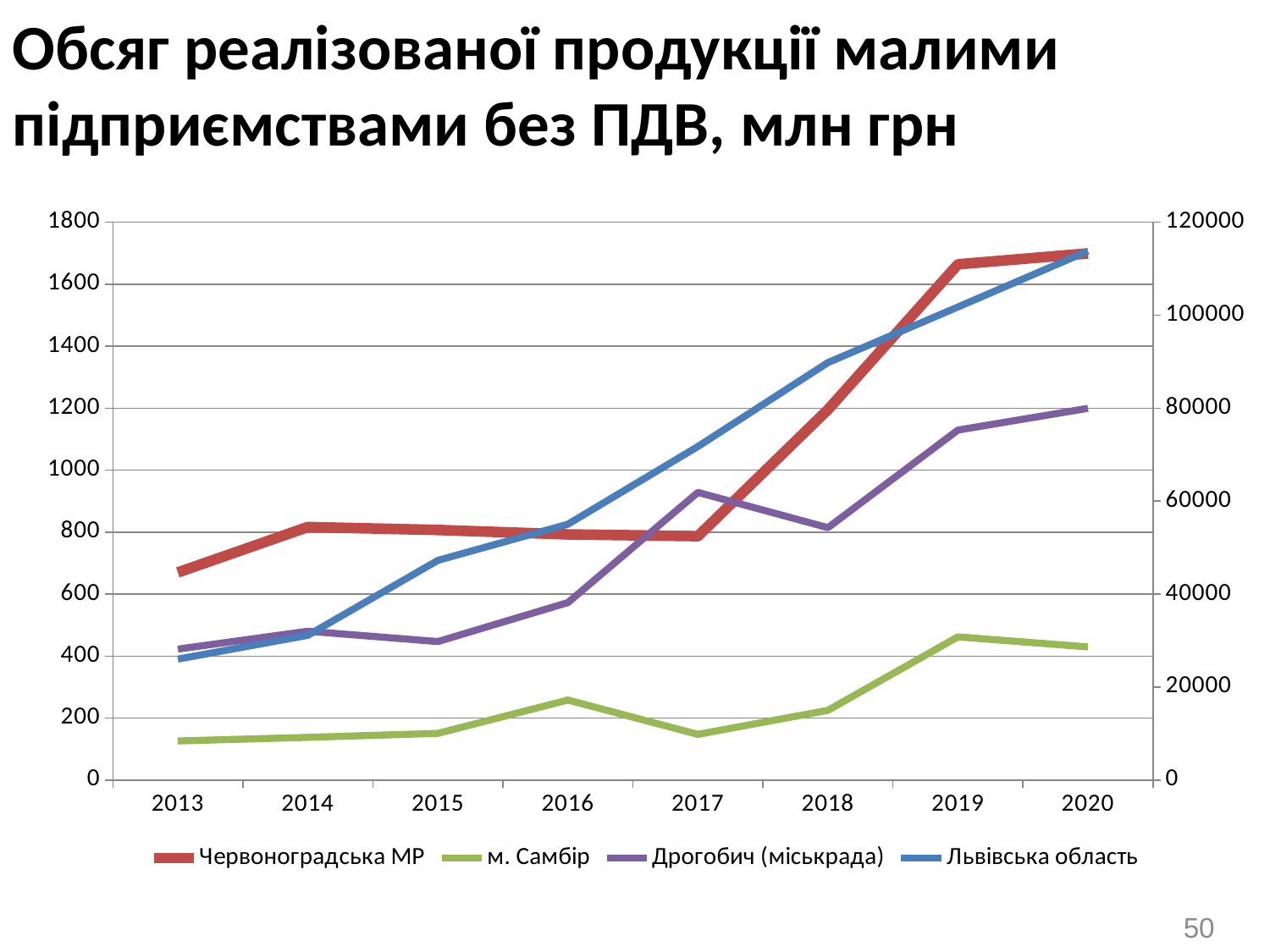
In 2017, which is larger: Дрогобич (міськрада) or Червоноградська МР? Дрогобич (міськрада) In which year is the value for м. Самбір highest? 2019 Which series is drawn in green? м. Самбір Is the value for Дрогобич (міськрада) in 2020 greater or less than 1000? greater Does the value for Львівська область rise or fall from 2013 to 2020? rise Is the value for Червоноградська МР in 2019 greater or less than 1400? greater In which year is the value for Червоноградська МР lowest? 2013 What kind of chart is shown on the slide? line chart Is the value for м. Самбір in 2020 greater or less than 600? less How many years are shown on the x axis? 8 How many series does the legend list? 4